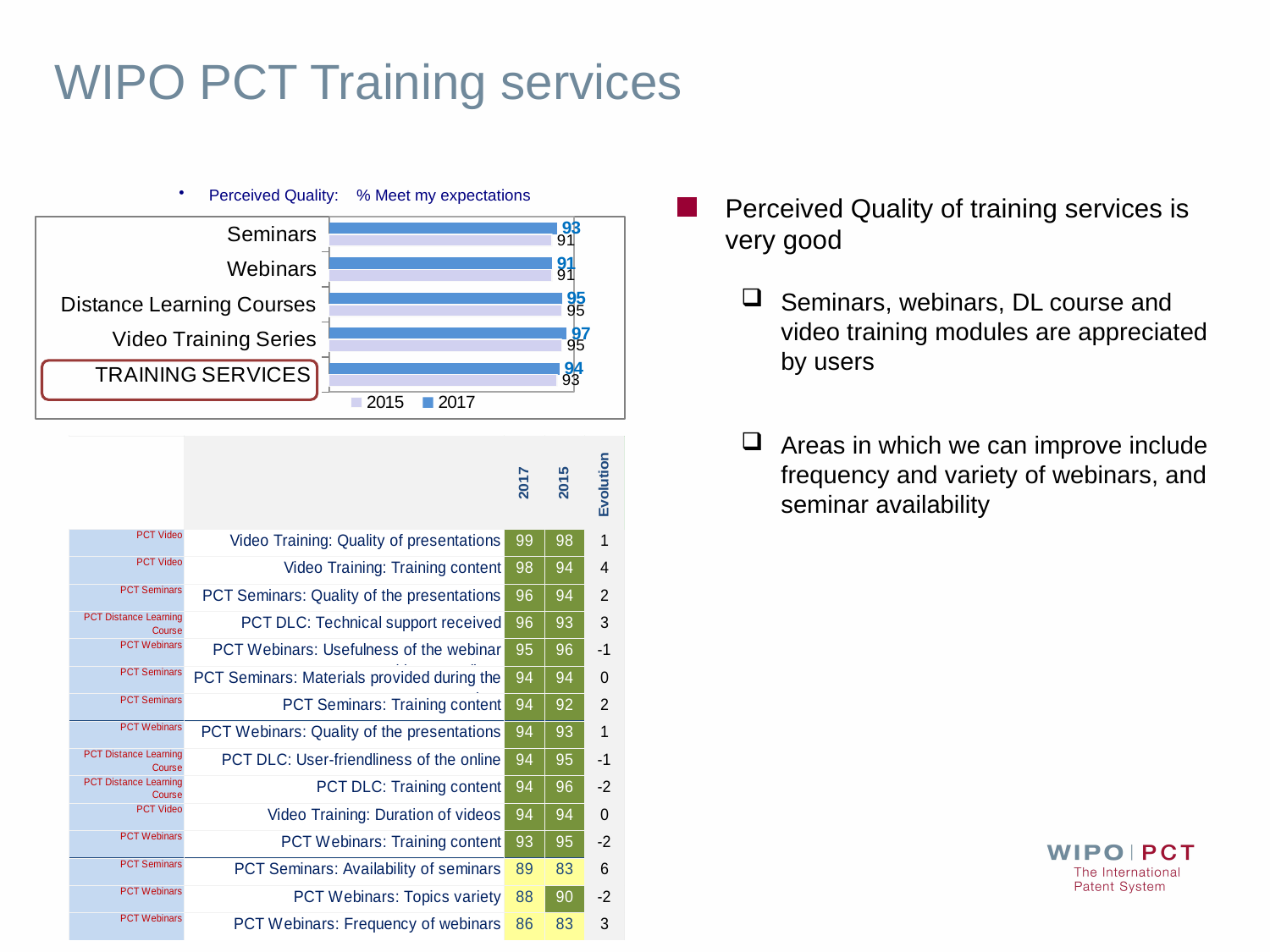
In the bar chart, what is the 2015 value for Webinars? 91 Which category has the lowest 2017 value in the bar chart? Webinars What is the 2015 value for Video Training Series in the bar chart? 95 What type of chart is shown under 'Perceived Quality: % Meet my expectations'? bar chart Which two years are listed in the legend of the bar chart? 2015 and 2017 What is the 2017 value for Seminars in the bar chart? 93 How many categories are shown in the bar chart? 5 How many series does the legend of the bar chart list? 2 What is the 2017 value for TRAINING SERVICES in the bar chart? 94 In the bar chart, is the 2017 value for Video Training Series larger than the 2017 value for Distance Learning Courses? Yes In the bar chart, what is the difference between the 2017 and 2015 values for Seminars? 2 Which category has the highest 2017 value in the bar chart? Video Training Series